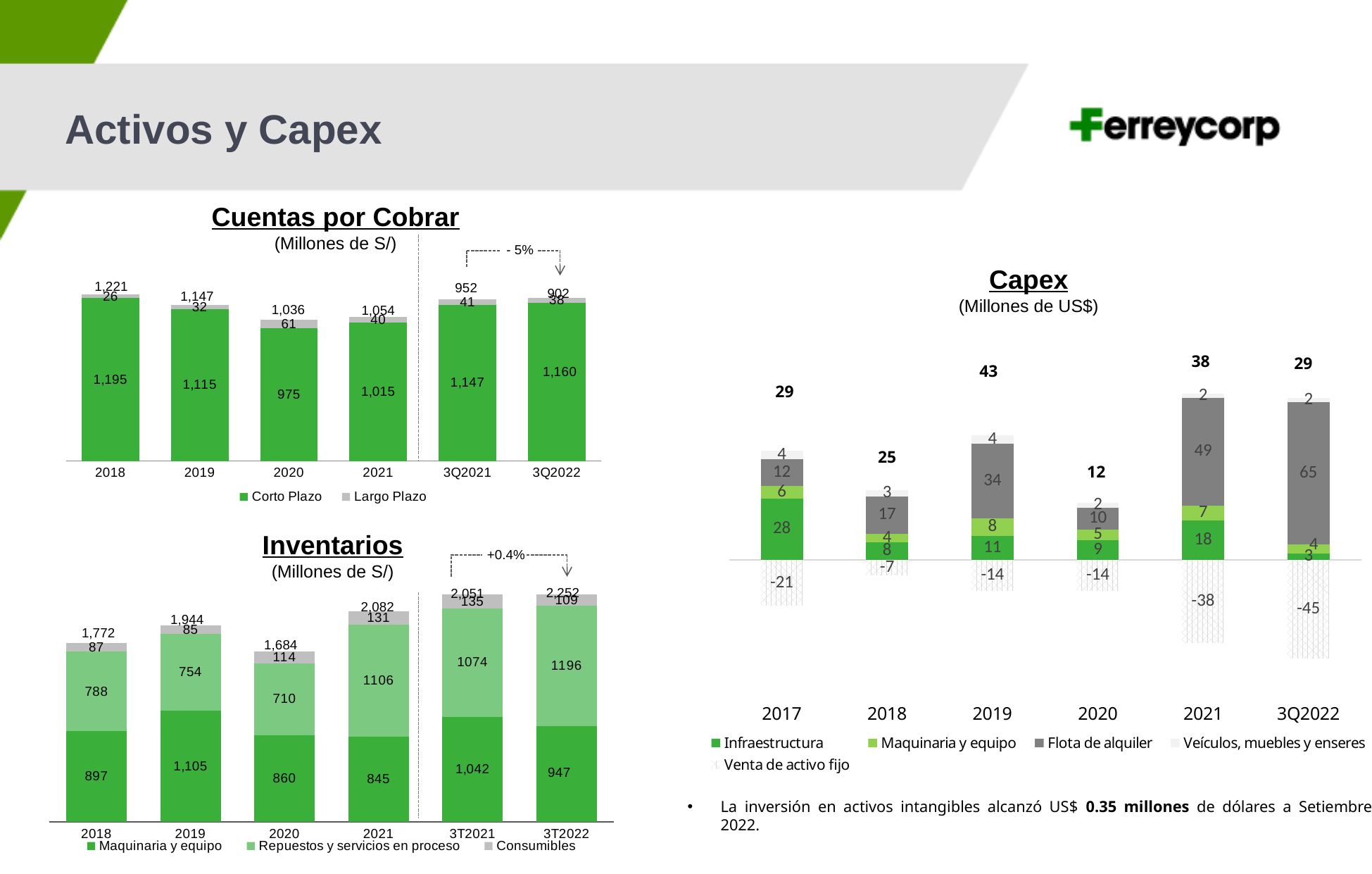
In the Cuentas por Cobrar chart, which year from 2018 to 2021 has the highest total? 2018 In the Inventarios chart, which period has the lowest total? 2020 In the Cuentas por Cobrar chart, what is the Largo Plazo value for 2021? 40 In the Cuentas por Cobrar chart, how many series does the legend list? 2 In the Inventarios chart, what is the Repuestos y servicios en proceso value for 3T2022? 1196 In the Capex chart, what is the Venta de activo fijo value for 2021? -38 In the Inventarios chart, what is the total for 2019? 1,944 What kind of chart is the Capex chart? Stacked bar chart In the Cuentas por Cobrar chart, what is the Corto Plazo value for 2020? 975 In the Inventarios chart, what is the difference between the Maquinaria y equipo values for 2019 and 2018? 208 In the Capex chart, which year has the highest total? 2019 In the Capex chart, what is the Flota de alquiler value for 3Q2022? 65